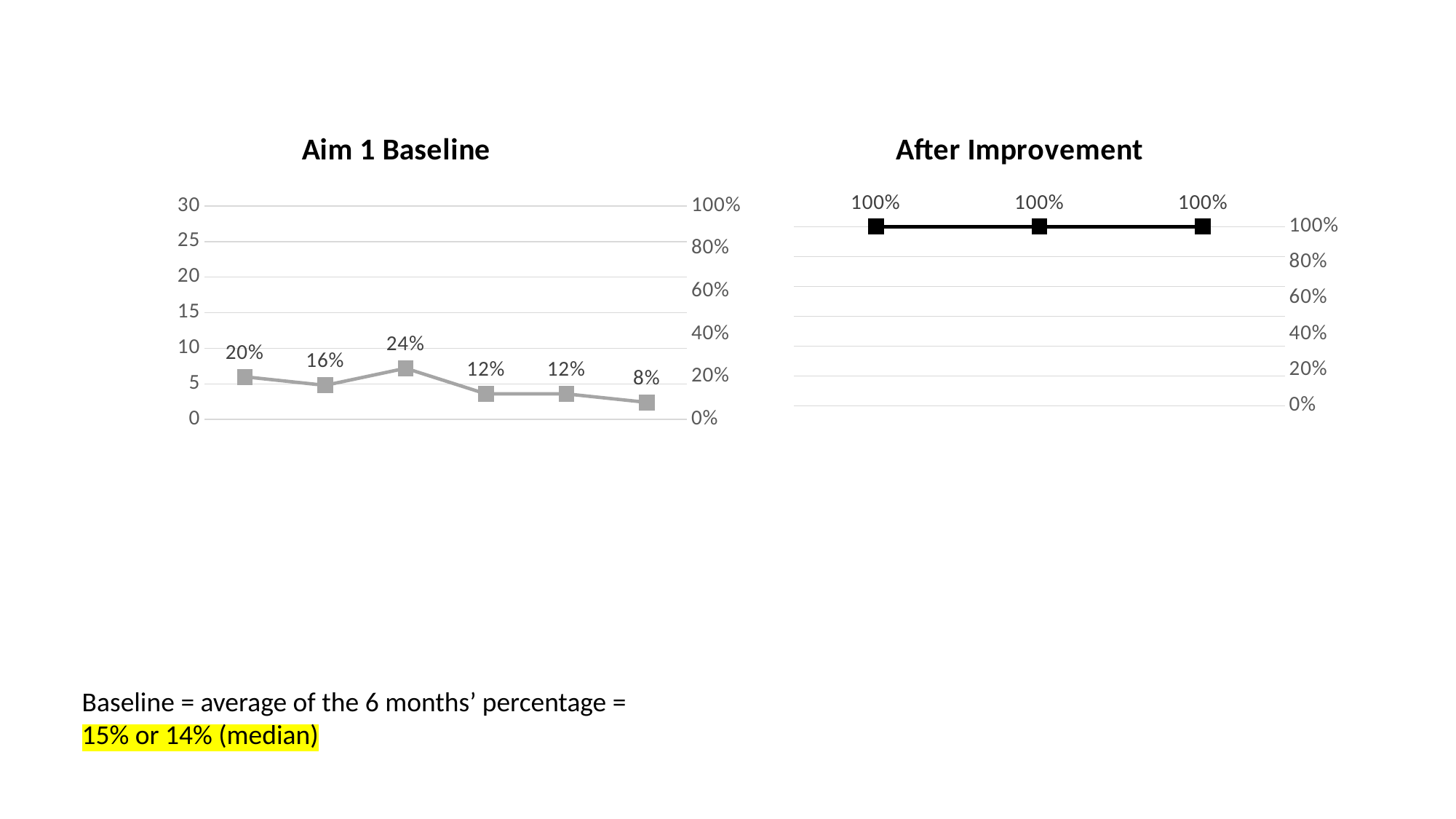
In the "After Improvement" chart, what is the value of each data point? 100% In the "Aim 1 Baseline" chart, what is the value of the last data point? 8% In the "After Improvement" chart, do the values rise, fall, or stay flat across the points? stay flat In the "After Improvement" chart, how many data points are plotted? 3 In the "Aim 1 Baseline" chart, what is the difference between the third data point and the last data point? 16% In the "Aim 1 Baseline" chart, what is the lowest value shown? 8% In the "Aim 1 Baseline" chart, what is the value of the third data point? 24% In the "Aim 1 Baseline" chart, what is the value of the first data point? 20% In the "Aim 1 Baseline" chart, what is the highest value shown? 24% In the "Aim 1 Baseline" chart, which is larger, the first data point or the second data point? the first data point (20%) In the "Aim 1 Baseline" chart, how many data points are plotted? 6 What type of chart is the "Aim 1 Baseline" chart? line chart